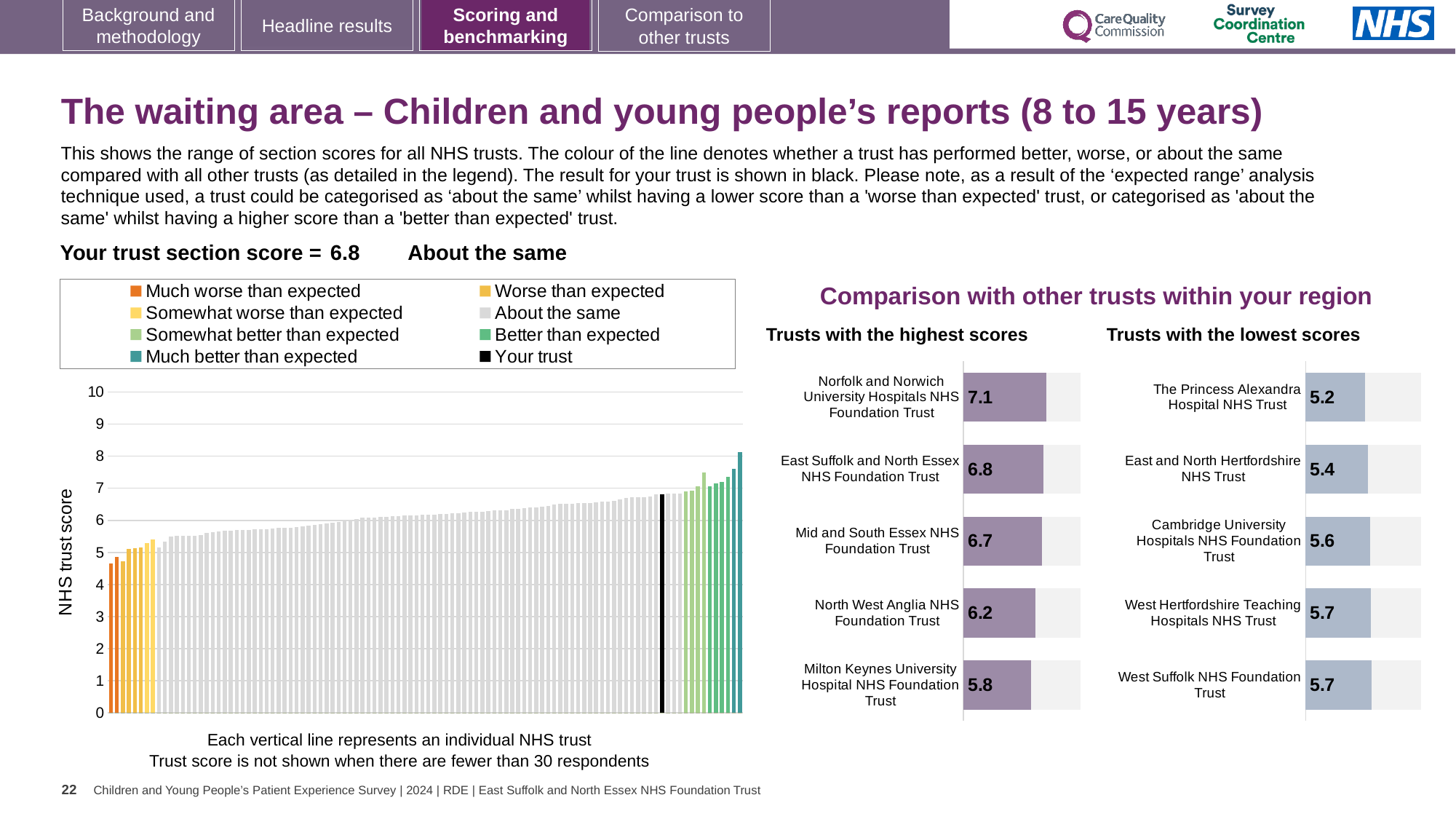
In the 'Trusts with the highest scores' chart, what is the difference between the scores of Norfolk and Norwich University Hospitals NHS Foundation Trust and Milton Keynes University Hospital NHS Foundation Trust? 1.3 In the 'Trusts with the lowest scores' chart, what is the score for The Princess Alexandra Hospital NHS Trust? 5.2 In the large chart on the left showing all NHS trusts, do the bar values rise or fall from left to right? rise In the large chart on the left showing all NHS trusts, is the value for the black 'Your trust' bar greater or less than 6? greater In the 'Trusts with the highest scores' chart, what is the score for Mid and South Essex NHS Foundation Trust? 6.7 How many trusts are listed in the 'Trusts with the lowest scores' chart? 5 In the 'Trusts with the lowest scores' chart, what is the difference between the scores of Cambridge University Hospitals NHS Foundation Trust and The Princess Alexandra Hospital NHS Trust? 0.4 In the 'Trusts with the lowest scores' chart, what is the score for Cambridge University Hospitals NHS Foundation Trust? 5.6 In the 'Trusts with the highest scores' chart, which has the higher score: East Suffolk and North Essex NHS Foundation Trust or North West Anglia NHS Foundation Trust? East Suffolk and North Essex NHS Foundation Trust In the 'Trusts with the highest scores' chart, what is the score for Norfolk and Norwich University Hospitals NHS Foundation Trust? 7.1 In the 'Trusts with the highest scores' chart, which trust has the lowest score? Milton Keynes University Hospital NHS Foundation Trust How many entries does the legend of the large chart on the left list? 8